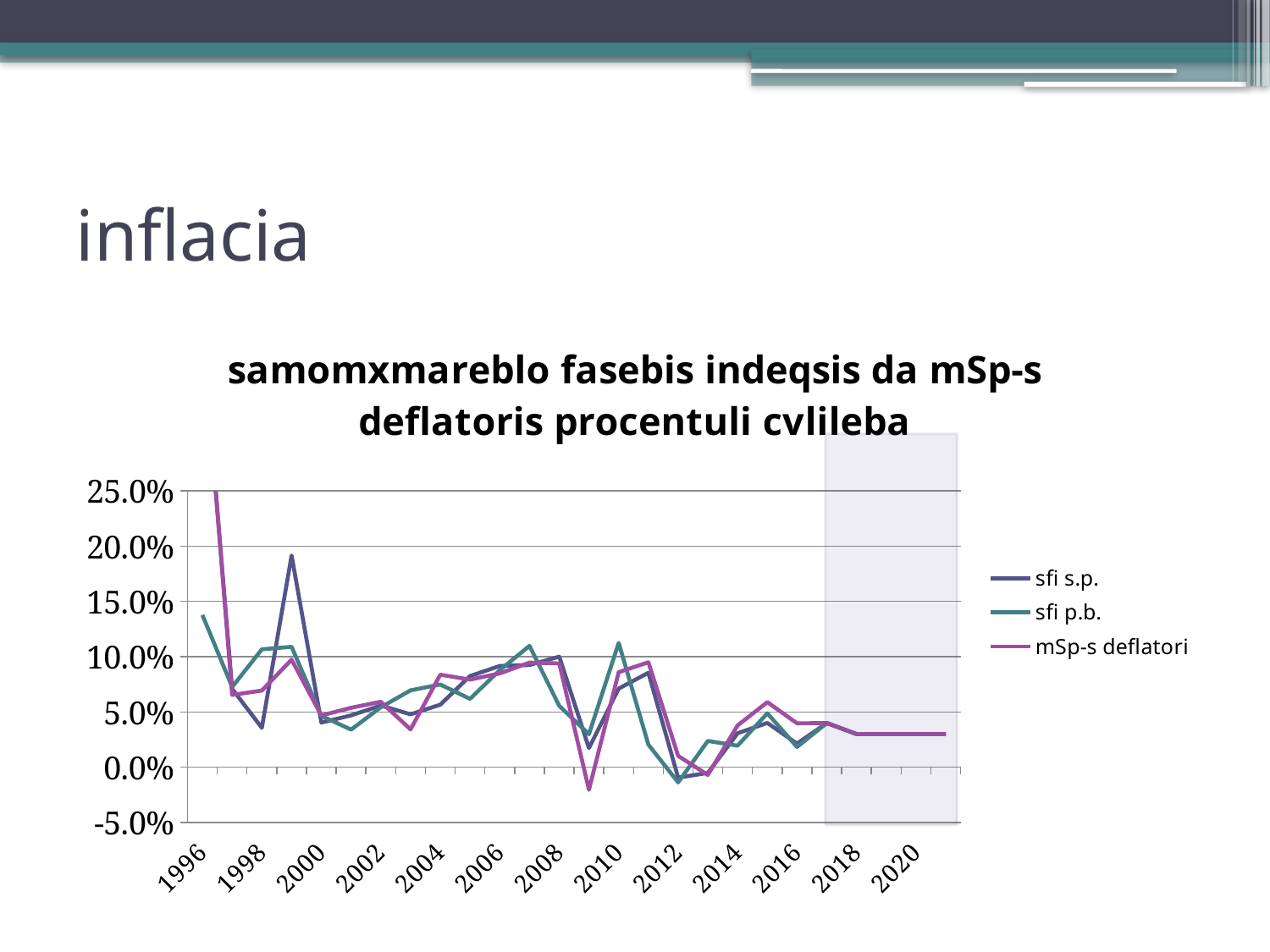
What kind of chart is shown on the slide? line chart What is the title of the chart? samomxmareblo fasebis indeqsis da mSp-s deflatoris procentuli cvlileba Is the value of sfi s.p. in 1999 greater or less than 15.0%? greater Which series is drawn in magenta/purple according to the legend? mSp-s deflatori Overall, do the series values rise or fall from 1996 to 2020? fall Is the value of sfi p.b. in 1996 greater or less than 10.0%? greater Is the value of mSp-s deflatori in 2020 greater or less than 5.0%? less In which year does the mSp-s deflatori series reach its highest value? 1996 How many series does the legend list? 3